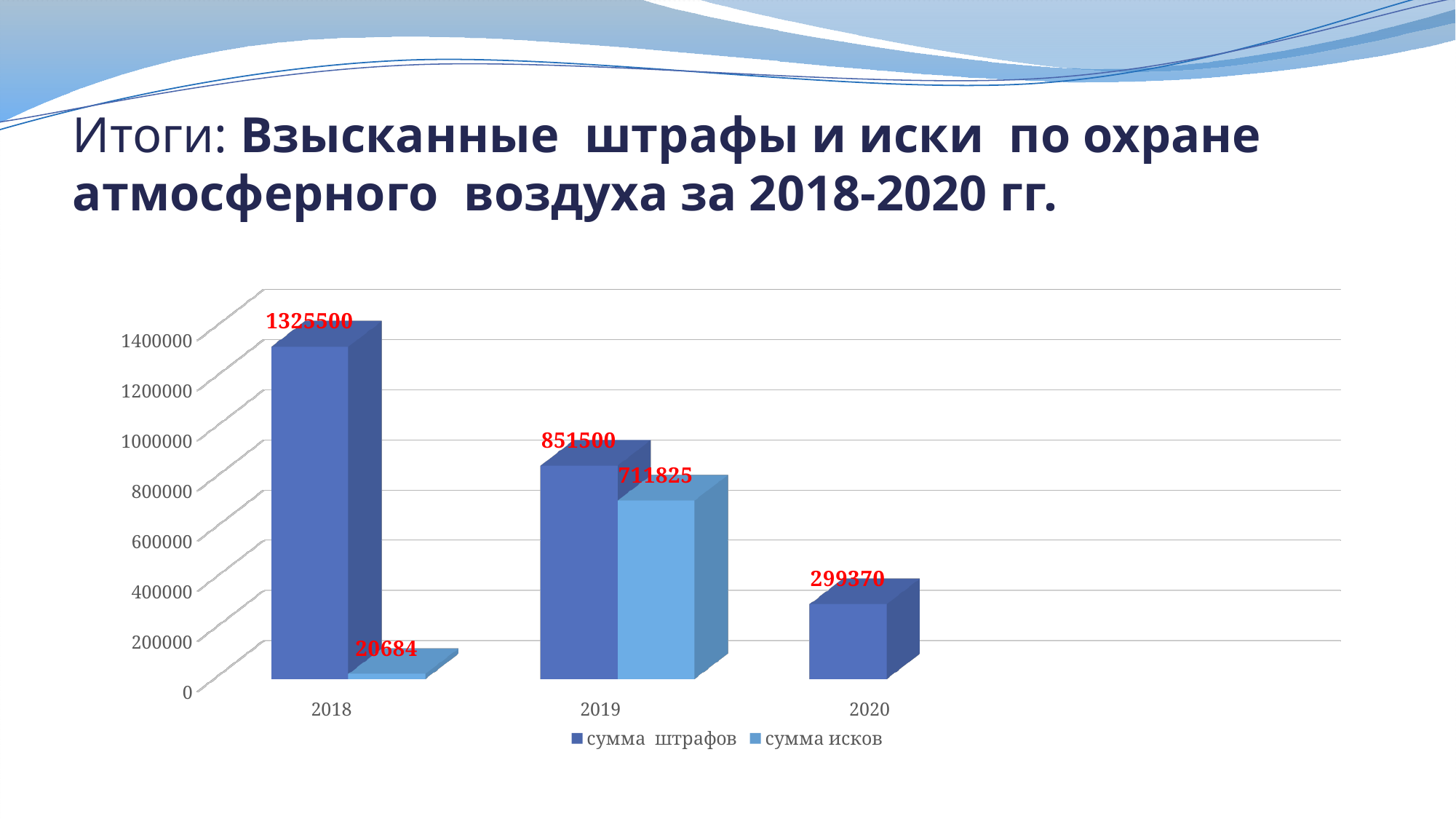
What is the value of сумма штрафов for 2018? 1325500 What is the difference between сумма штрафов and сумма исков in 2019? 139675 What is the difference between сумма штрафов in 2018 and in 2019? 474000 What kind of chart is shown on the slide? bar chart How many series does the legend list? 2 Does сумма штрафов rise or fall from 2018 to 2020? fall Which year has the lowest value for сумма штрафов? 2020 Which year has the highest value for сумма штрафов? 2018 What is the value of сумма исков for 2019? 711825 Which is larger in 2019: сумма штрафов or сумма исков? сумма штрафов What is the value of сумма исков for 2018? 20684 What is the value of сумма штрафов for 2020? 299370